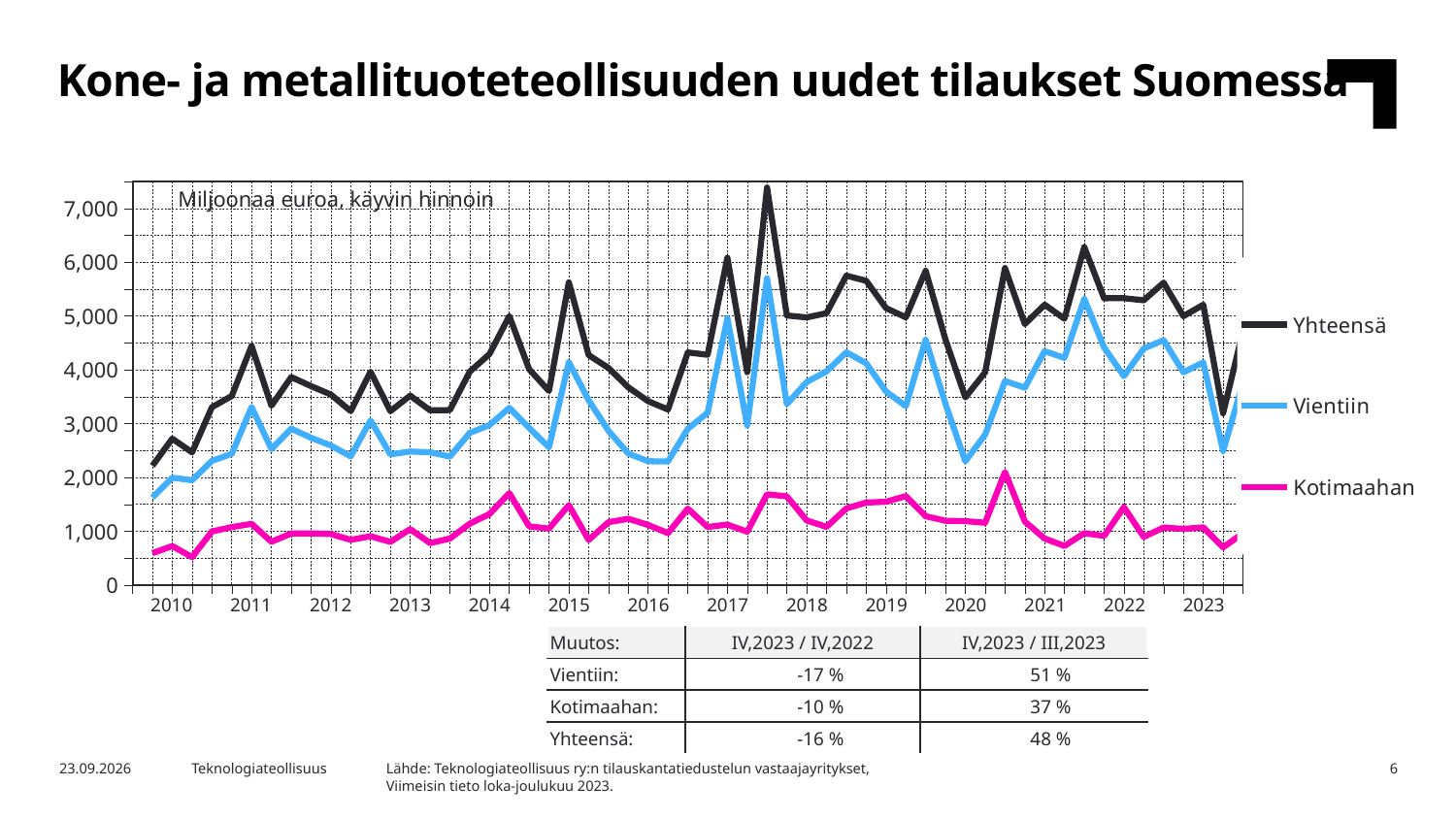
Which series has the lowest values throughout the chart? Kotimaahan What are the three series named in the legend? Yhteensä, Vientiin, Kotimaahan How many series does the legend list? 3 How many years are labelled on the x axis? 14 Is the value for Vientiin at the start of 2010 greater or less than 2,000? less What kind of chart is shown on the slide? line chart What unit is stated in the label at the top of the chart? Miljoonaa euroa, käyvin hinnoin Which series is larger in 2021, Vientiin or Kotimaahan? Vientiin Is the peak value of Yhteensä in 2017 greater or less than 7,000? greater Does the Yhteensä series generally rise or fall from 2010 to its peak in 2017? rise Is the highest value of Kotimaahan greater or less than 3,000? less Which series has the highest values throughout the chart? Yhteensä